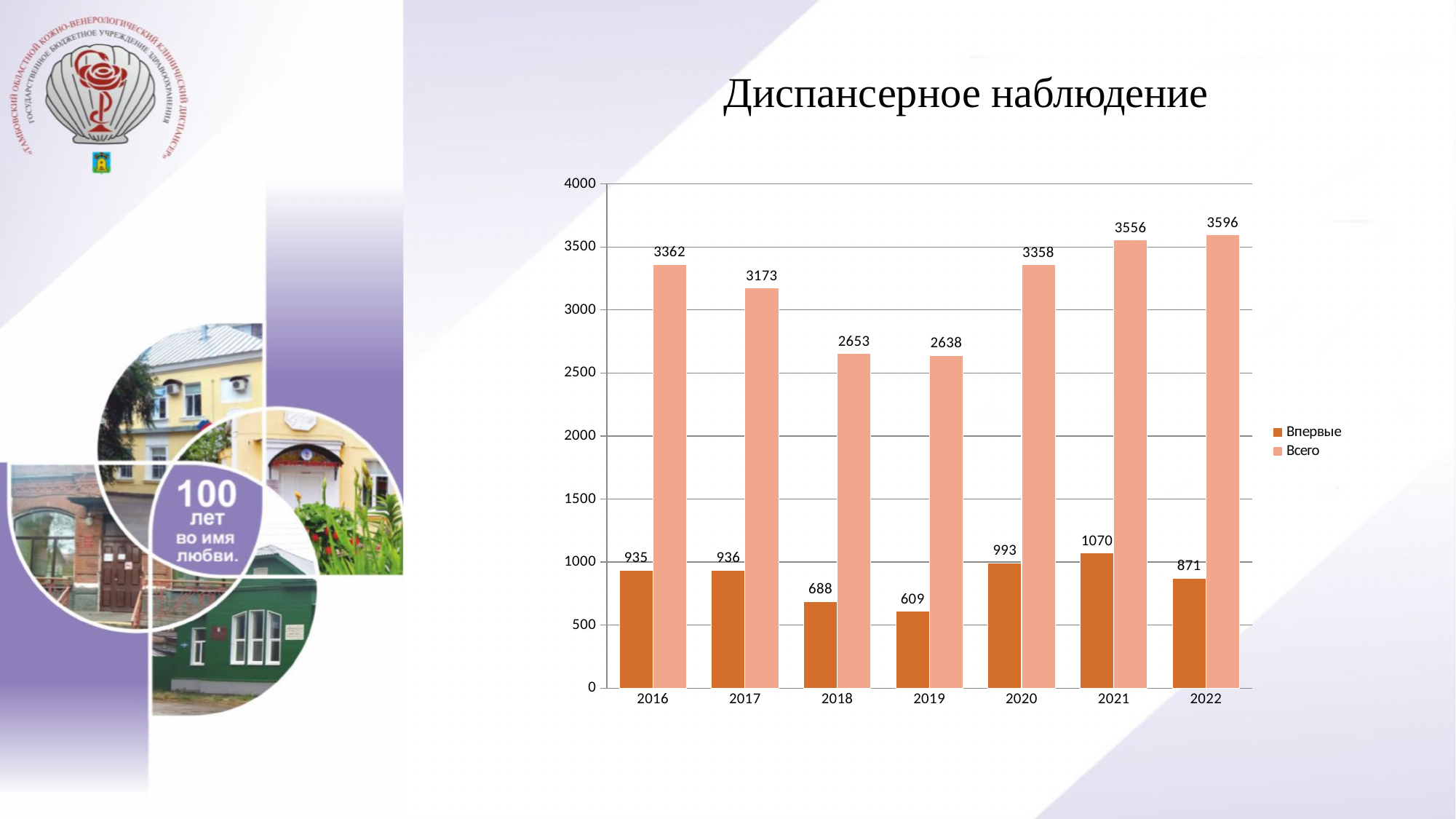
What is the difference between Впервые in 2020 and Впервые in 2018? 305 How many series does the legend list? 2 What is the title of the chart? Диспансерное наблюдение What is the value for Впервые in 2019? 609 How many years are shown on the x axis? 7 Which year has the lowest value for Впервые? 2019 What is the value for Всего in 2016? 3362 What kind of chart is shown on the slide? bar chart Which year has the highest value for Всего? 2022 Which is larger: Всего in 2018 or Всего in 2019? 2018 What is the difference between Всего in 2022 and Всего in 2021? 40 What is the value for Впервые in 2021? 1070